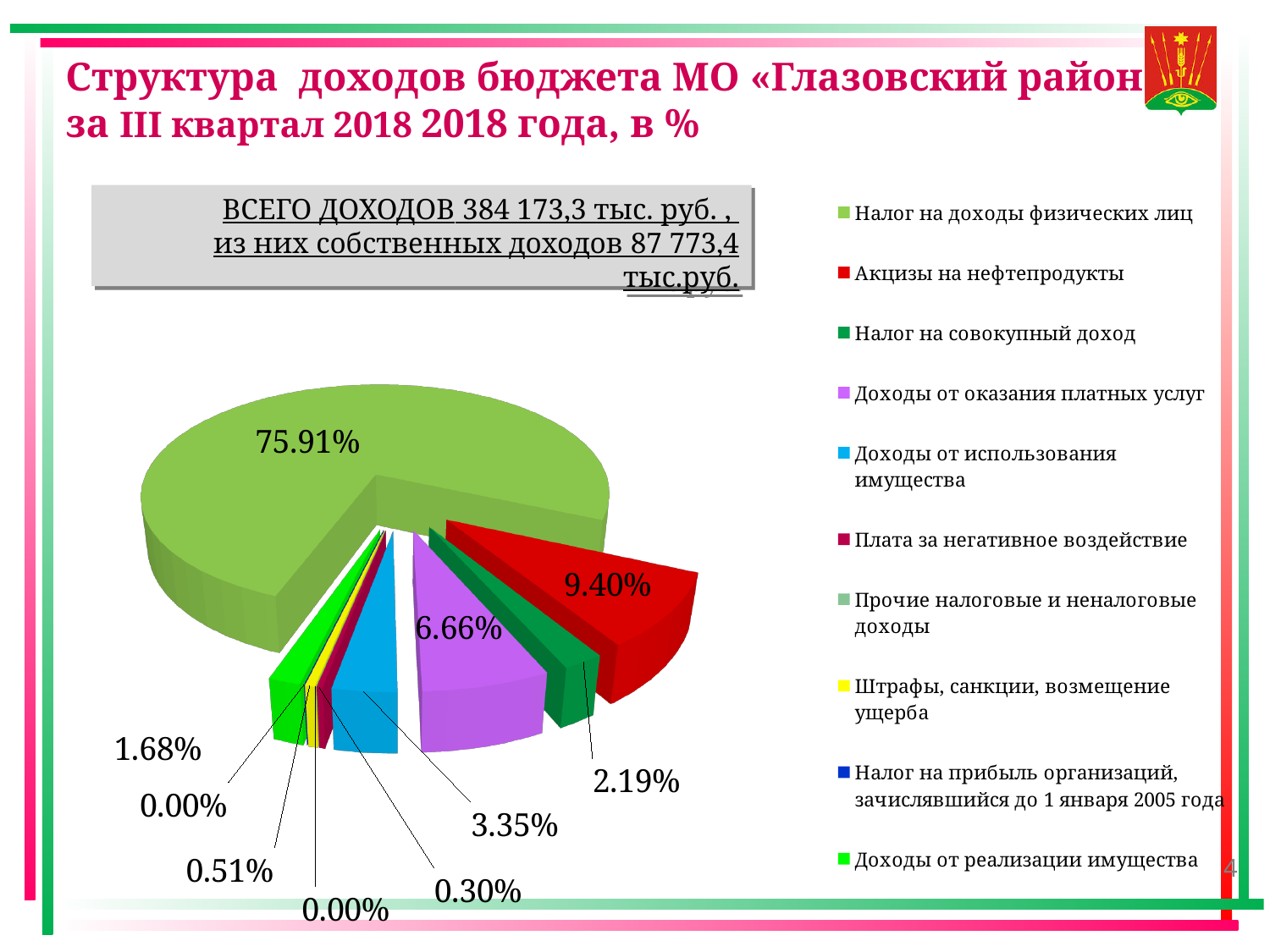
How many entries does the legend of the pie chart list? 10 What share of the pie does Налог на доходы физических лиц have? 75.91% What is the value shown for Доходы от оказания платных услуг? 6.66% What is the value shown for Доходы от использования имущества? 3.35% What is the value shown for Акцизы на нефтепродукты? 9.40% Which category has the largest share of the pie chart? Налог на доходы физических лиц What total income amount (ВСЕГО ДОХОДОВ) is stated in the box above the chart? 384 173,3 тыс. руб. What kind of chart is shown on the slide? pie chart What is the value shown for Налог на совокупный доход? 2.19% What is the value shown for Доходы от реализации имущества? 1.68% What is the difference between the share for Налог на доходы физических лиц and the share for Акцизы на нефтепродукты? 66.51% Which is larger: the share for Акцизы на нефтепродукты or the share for Доходы от оказания платных услуг? Акцизы на нефтепродукты